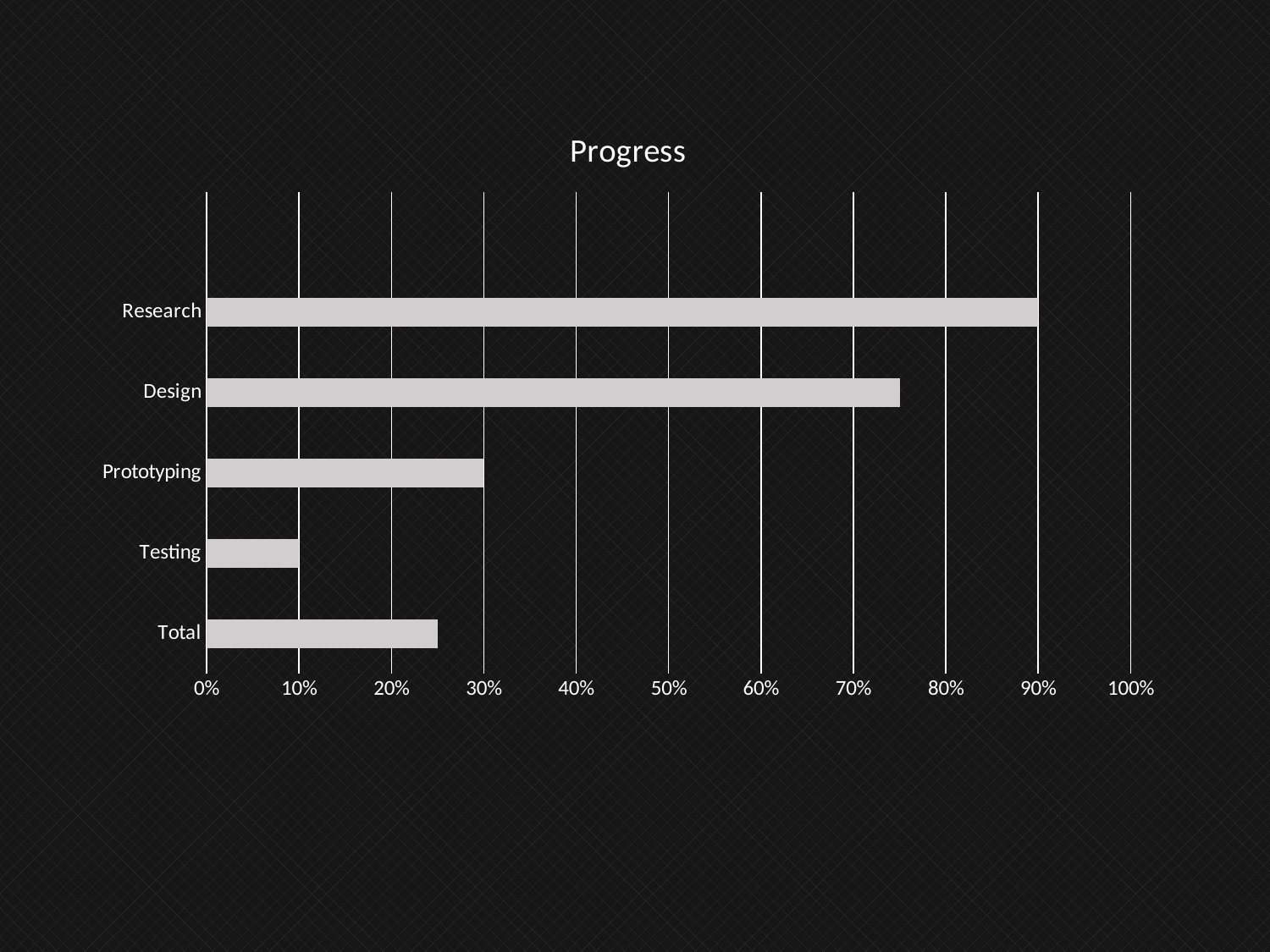
Is the value for Total greater or less than 30%? less What is the value for Research? 90% What type of chart is shown on the slide? bar chart Is the value for Design greater or less than 70%? greater Which is larger, the value for Design or the value for Prototyping? Design How many categories are shown in the chart? 5 What is the value for Testing? 10% What is the title of the chart? Progress Which category has the lowest value? Testing Which category has the highest value? Research What is the difference between the values for Research and Prototyping? 60% What is the value for Prototyping? 30%